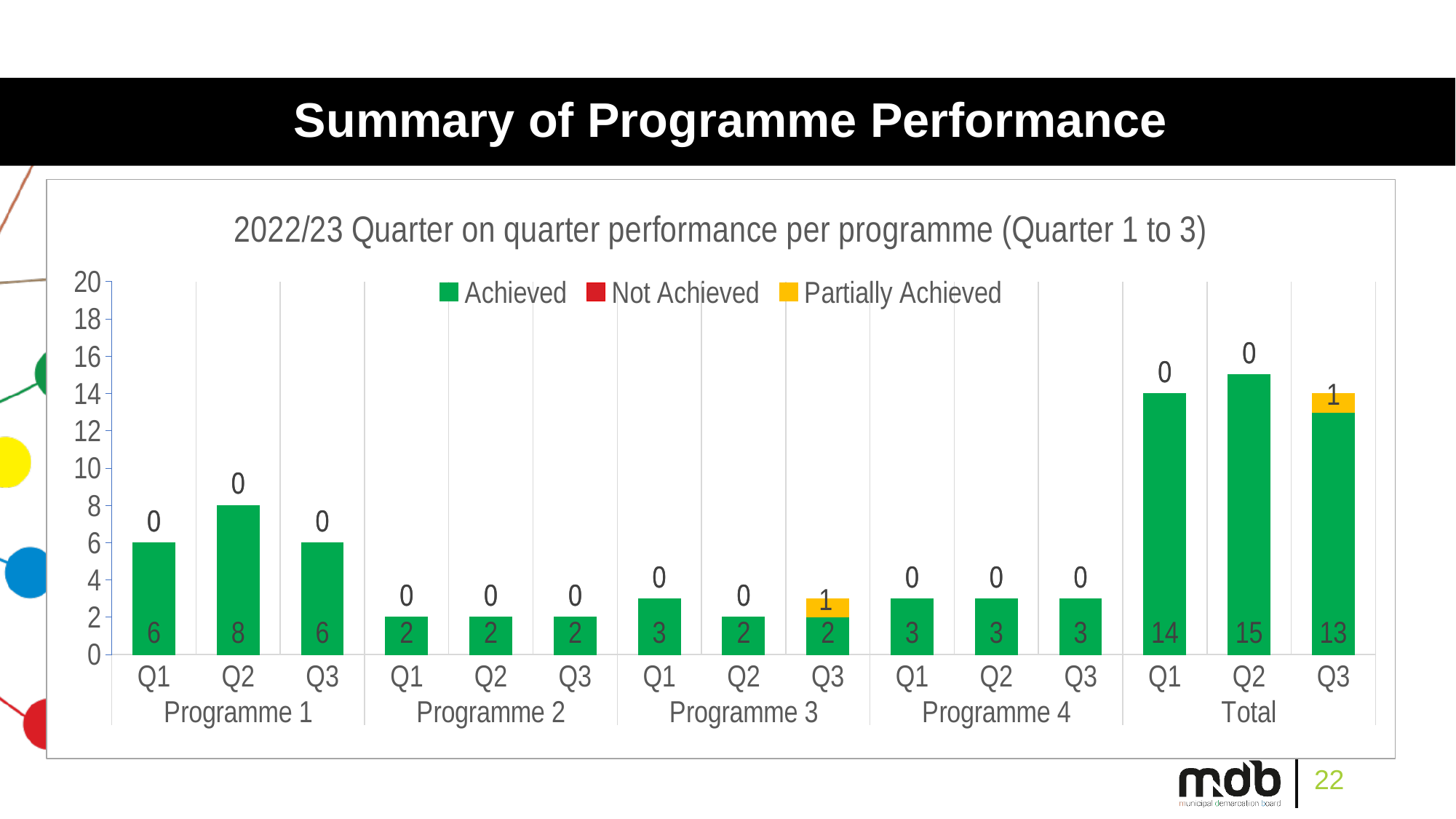
Which quarter has the lowest Achieved value under Total? Q3 What kind of chart is shown on the slide? Stacked bar chart Which is larger, the Achieved value for Programme 3 Q1 or Programme 2 Q1? Programme 3 Q1 What is the Achieved value for Programme 4 in Q1? 3 What is the Achieved value for Total in Q2? 15 What is the total height of the stacked bar for Total in Q3 (Achieved plus Partially Achieved)? 14 What is the title of the chart? 2022/23 Quarter on quarter performance per programme (Quarter 1 to 3) What is the Achieved value for Programme 1 in Q2? 8 How many series does the legend list? 3 What is the difference between the Achieved values for Total in Q2 and Total in Q3? 2 Which quarter has the highest Achieved value for Programme 1? Q2 What is the Partially Achieved value for Programme 3 in Q3? 1